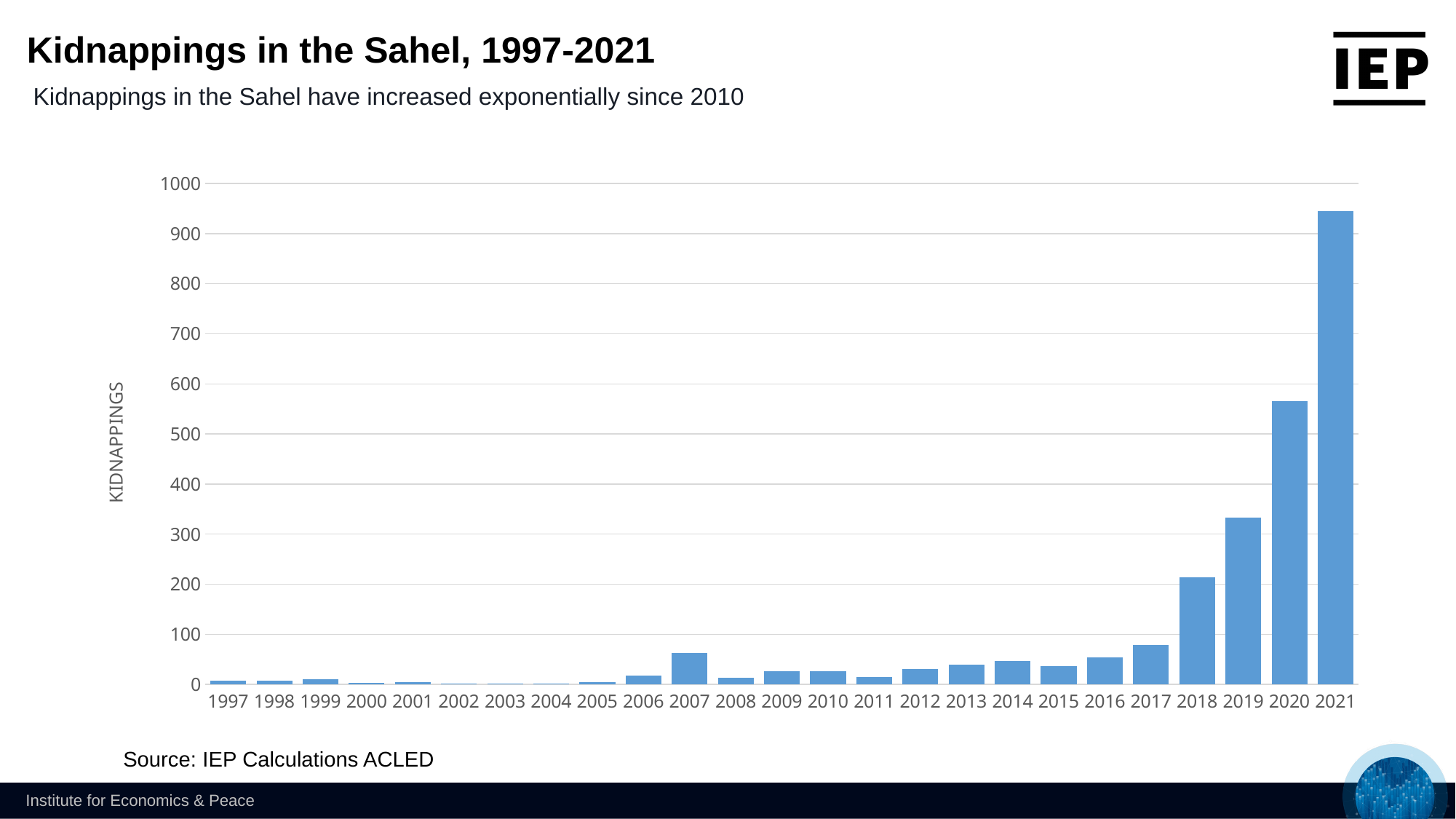
Is the value for 2018 greater or less than 200? greater Do the values rise or fall from 2017 to 2021? rise What kind of chart is shown on the slide? bar chart How many years are shown on the x axis? 25 Is the value for 2017 greater or less than 100? less Which year has more kidnappings, 2019 or 2020? 2020 Is the value for 2019 greater or less than 300? greater Which year has the highest number of kidnappings? 2021 Which year has more kidnappings, 2006 or 2007? 2007 What is the label on the y axis? KIDNAPPINGS